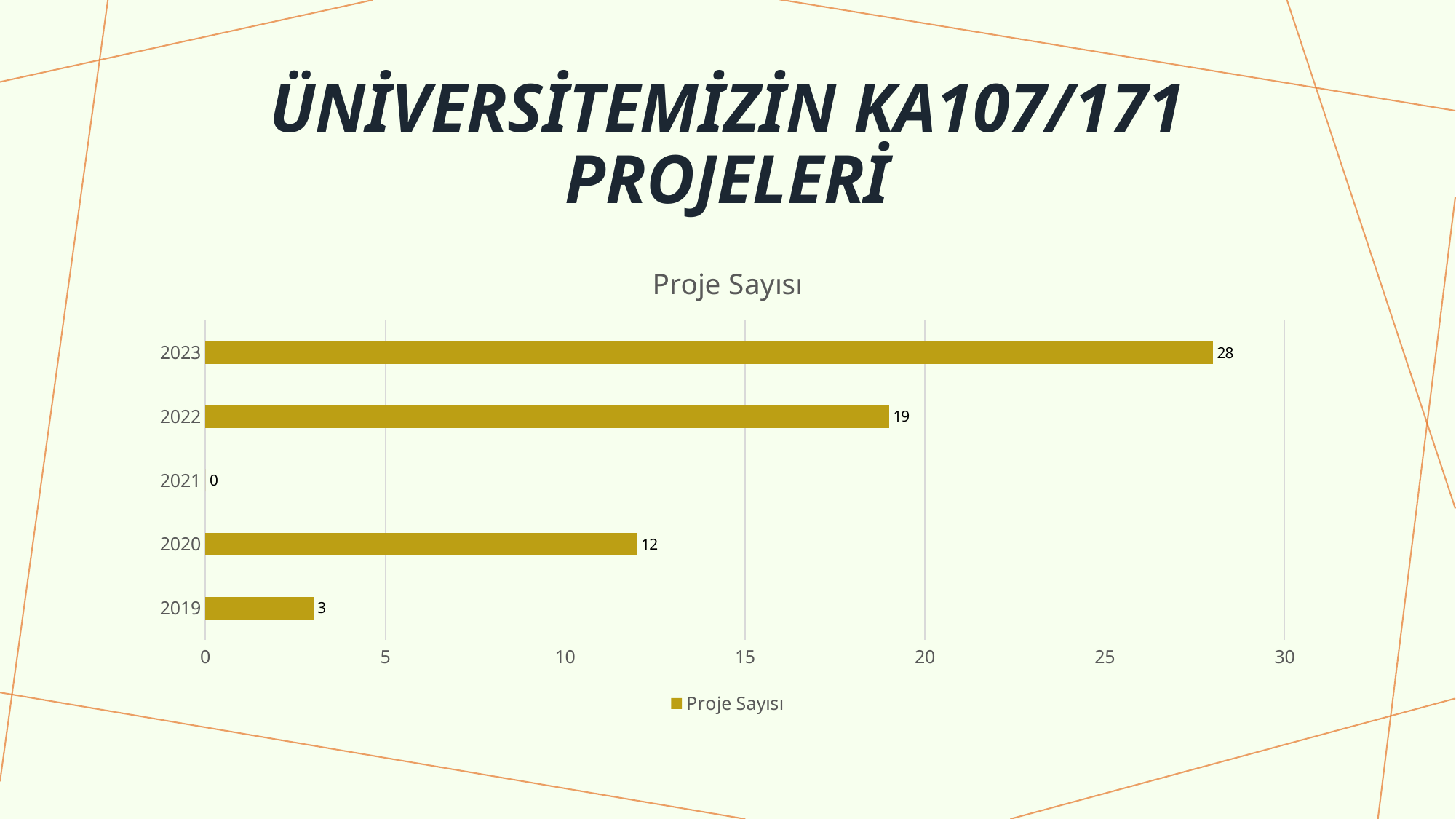
What is the value for 2019? 3 Which is larger, the value for 2020 or the value for 2019? 2020 How many years are shown on the chart? 5 Which year has the highest value? 2023 Is the value for 2022 greater or less than 15? greater What is the value for 2023? 28 What is the value for 2022? 19 What is the difference between the values for 2023 and 2022? 9 What kind of chart is shown? bar chart What is the title of the chart? Proje Sayısı What is the value for 2021? 0 Which year has the lowest value? 2021